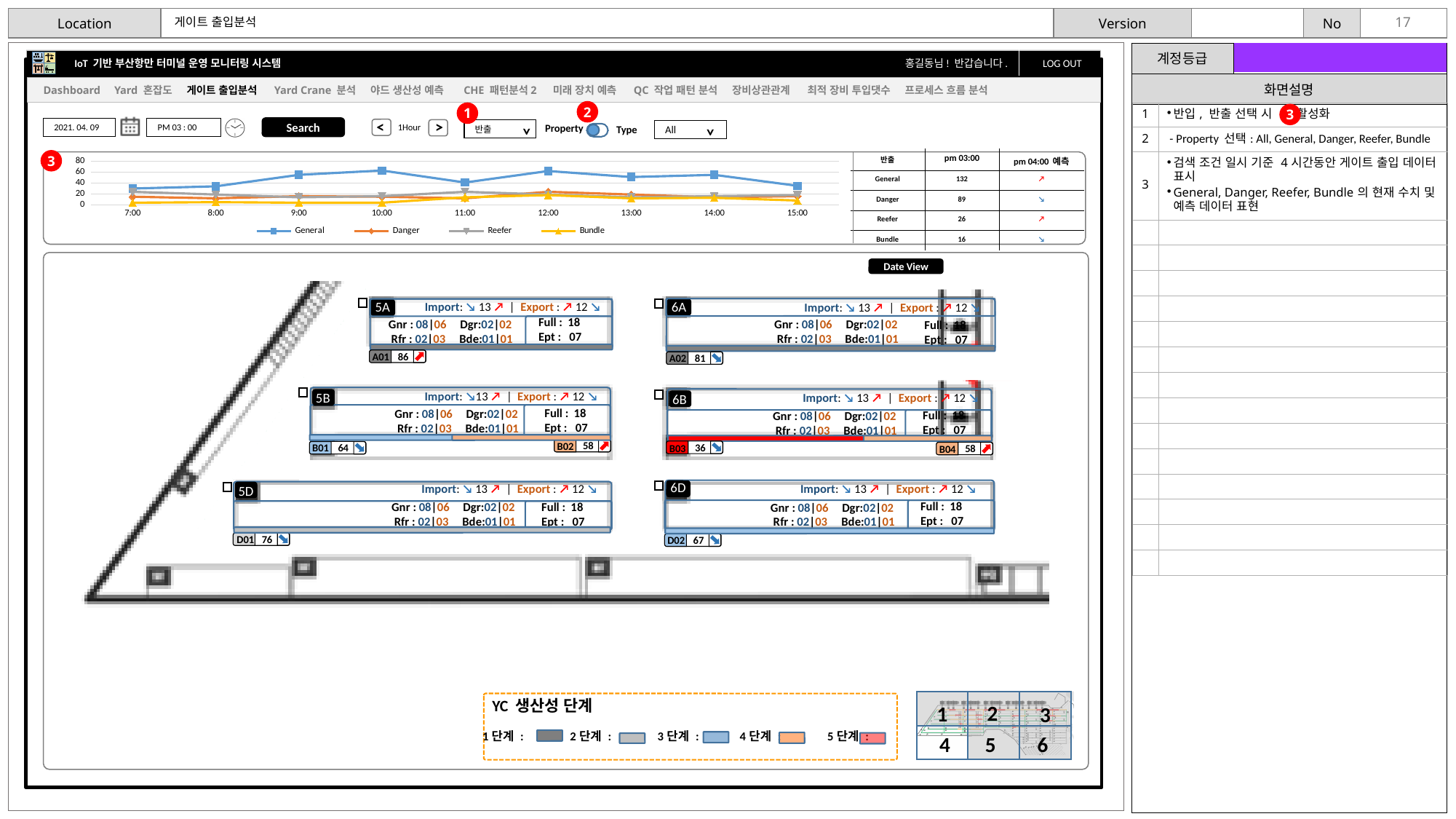
Is the value for Bundle at 7:00 greater or less than 20? less Is the value for General at 10:00 greater or less than 40? greater What colour is the General line in the chart? blue Does the General line rise or fall from 7:00 to 10:00? rise What are the four legend entries of the line chart? General, Danger, Reefer, Bundle Which series has the highest value at 12:00 in the line chart? General At 12:00, which is larger in the line chart, General or Bundle? General Does the General line rise or fall from 14:00 to 15:00? fall What kind of chart is shown at the top of the dashboard? line chart How many series does the legend of the line chart list? 4 How many time points are shown along the x axis of the line chart? 9 Is the value for General at 12:00 greater or less than 40? greater